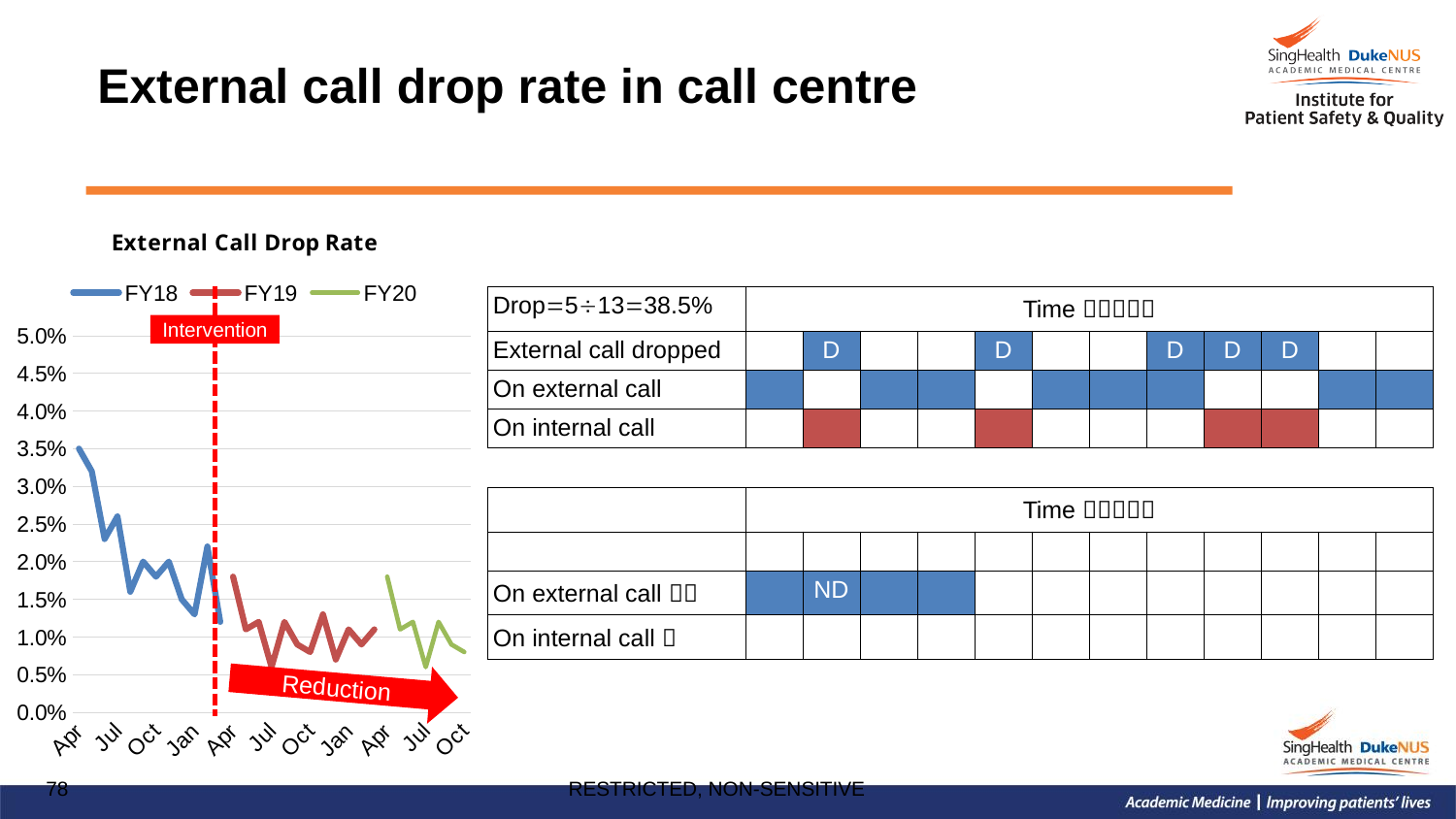
Is the highest FY20 value in the External Call Drop Rate chart greater or less than 2.5%? less Are all FY19 values in the External Call Drop Rate chart greater or less than 2.0%? less Which series has higher values overall in the External Call Drop Rate chart, FY18 or FY19? FY18 What kind of chart is the External Call Drop Rate chart? line chart How many month labels are shown on the x axis of the External Call Drop Rate chart? 11 Which series are listed in the legend of the External Call Drop Rate chart? FY18, FY19, FY20 What colour is the FY19 line in the External Call Drop Rate chart? red What is the highest value shown on the y axis of the External Call Drop Rate chart? 5.0% Does the FY18 line in the External Call Drop Rate chart rise or fall from Apr to the following Apr? fall Which series reaches the highest value in the External Call Drop Rate chart? FY18 Is the first FY18 value (Apr) in the External Call Drop Rate chart greater or less than 3.0%? greater How many series does the legend of the External Call Drop Rate chart list? 3